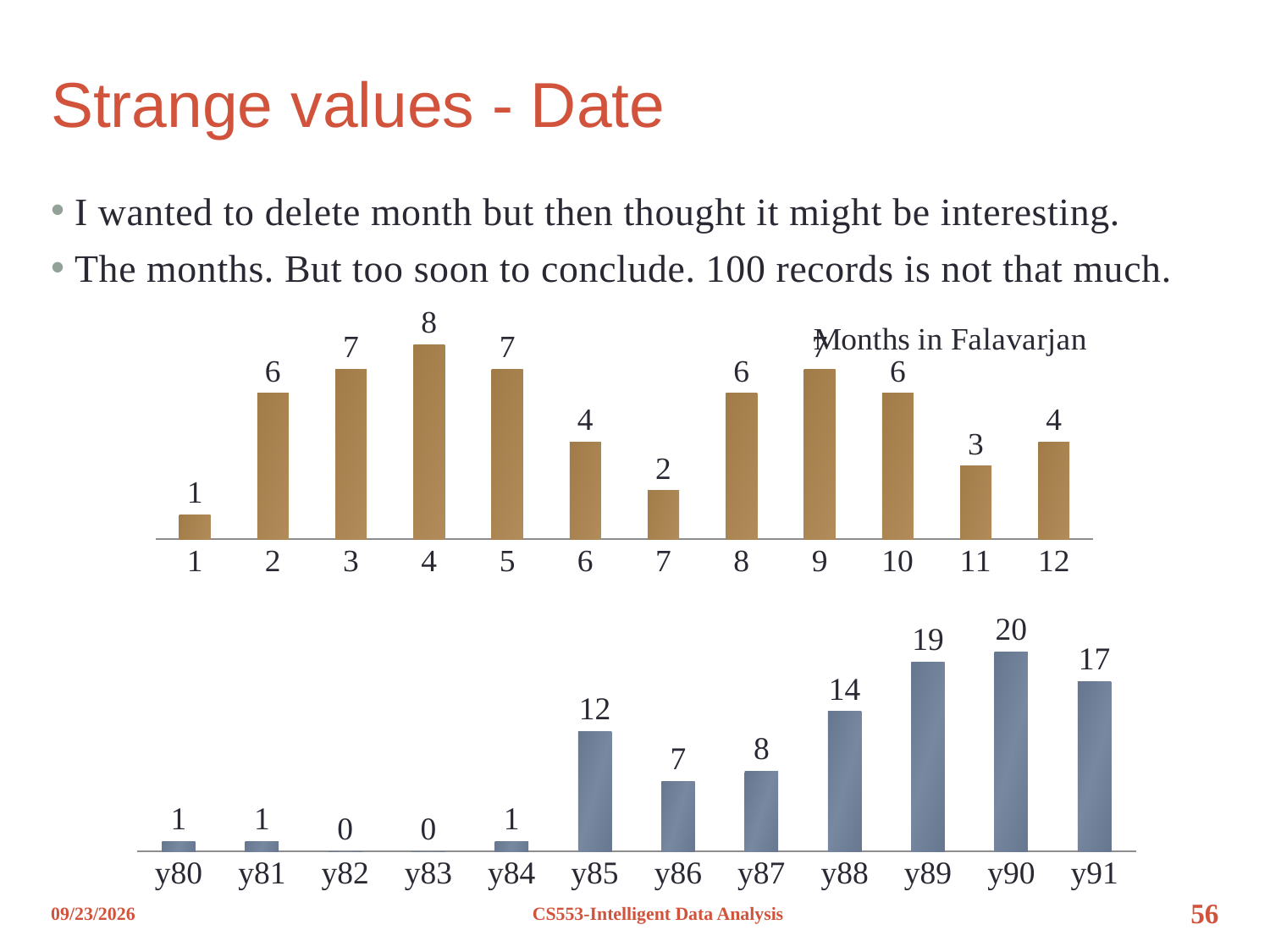
What is the title of the top chart? Months in Falavarjan In the bottom chart (years y80 to y91), how many years have a value of 0? 2 In the top chart (Months in Falavarjan), what is the difference between the values for month 4 and month 7? 6 In the top chart (Months in Falavarjan), which month has the highest value? 4 In the top chart (Months in Falavarjan), how many months are plotted? 12 In the top chart (Months in Falavarjan), what is the value for month 4? 8 In the bottom chart (years y80 to y91), what is the difference between the values for y90 and y91? 3 In the bottom chart (years y80 to y91), what is the value for y88? 14 In the bottom chart (years y80 to y91), which year has the highest value? y90 What kind of chart is the bottom chart (years y80 to y91)? Bar chart In the bottom chart (years y80 to y91), which is larger, the value for y85 or the value for y87? y85 In the top chart (Months in Falavarjan), which month has the lowest value? 1